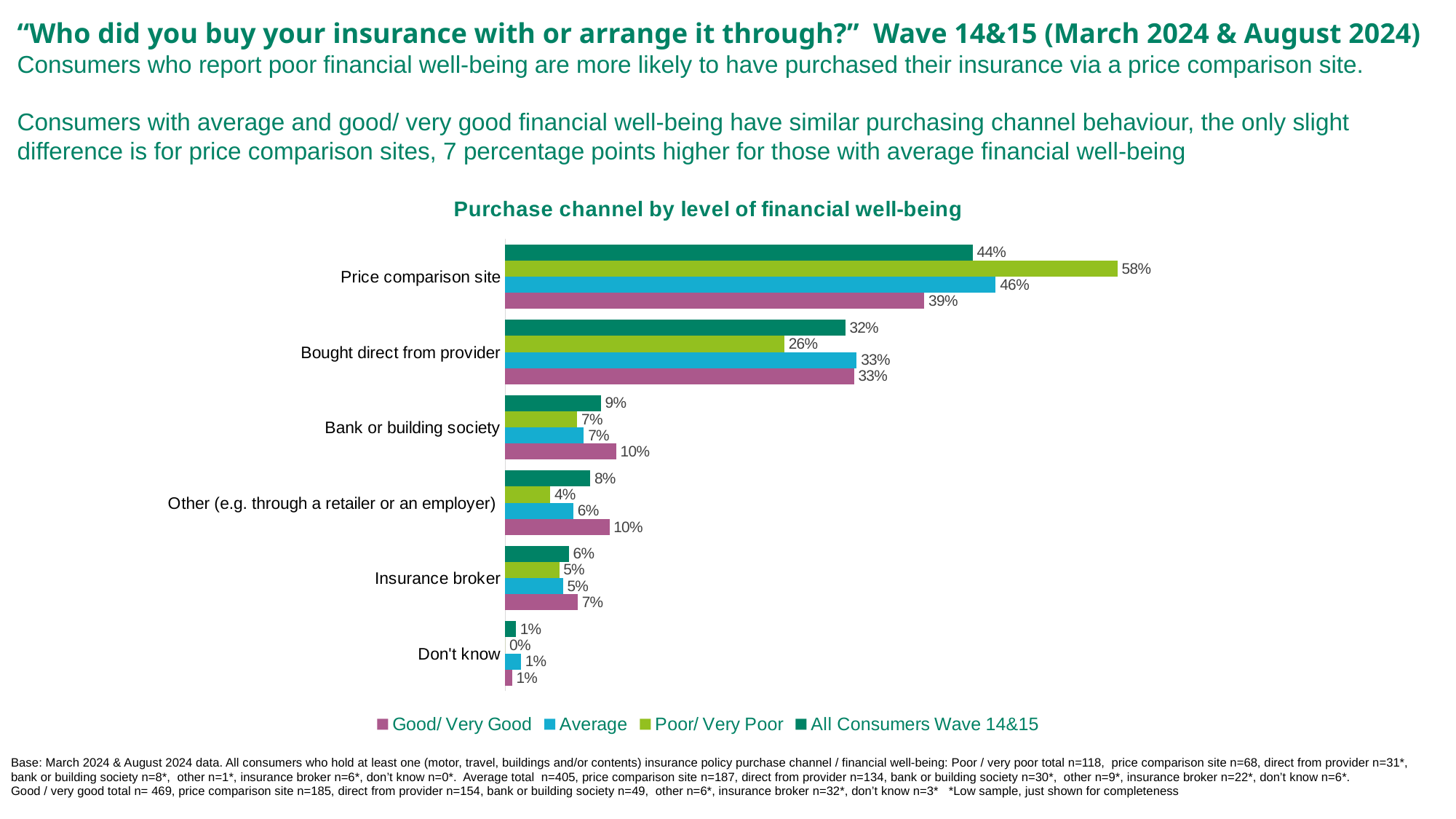
What is the value for Good/ Very Good consumers for 'Bought direct from provider'? 33% What percentage of Poor/ Very Poor consumers bought their insurance via a price comparison site? 58% Which series is shown in purple in the legend? Good/ Very Good What type of chart is shown on the slide? Bar chart What is the title of the chart? Purchase channel by level of financial well-being Which purchase channel has the highest value for the Average series? Price comparison site Which purchase channel has the lowest value for the Good/ Very Good series? Don't know How many series does the legend list? 4 For 'Other (e.g. through a retailer or an employer)', which is larger: the Good/ Very Good value or the Poor/ Very Poor value? Good/ Very Good How many purchase channel categories are shown on the chart? 6 What is the value for All Consumers Wave 14&15 for 'Bank or building society'? 9% What is the difference between the Poor/ Very Poor and Good/ Very Good values for 'Price comparison site'? 19 percentage points